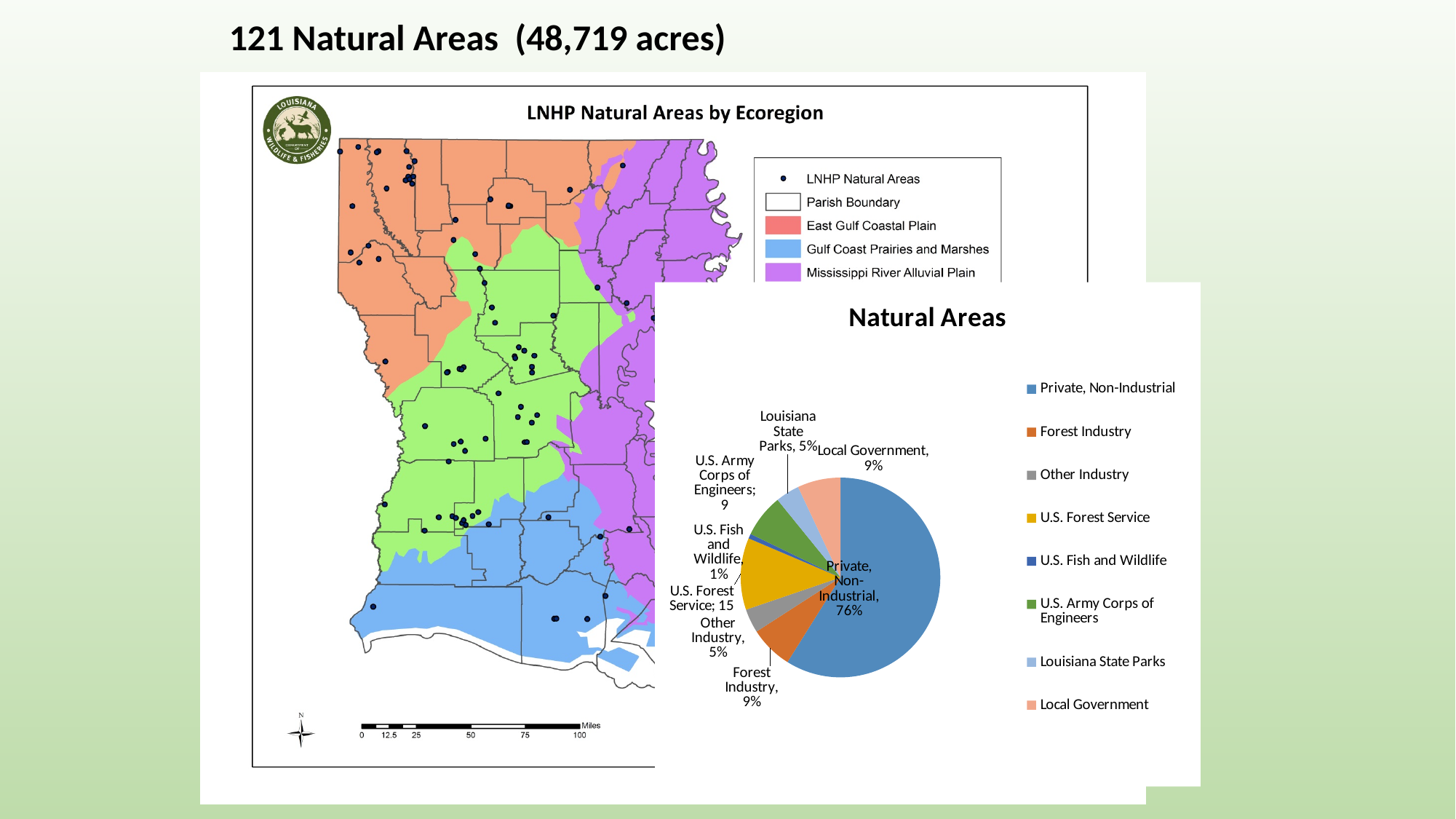
In the Natural Areas pie chart, what value is labelled for Other Industry? 5% In the Natural Areas pie chart, which category has the smallest slice? U.S. Fish and Wildlife In the Natural Areas pie chart, what share is labelled for Private, Non-Industrial? 76% In the Natural Areas pie chart, what value is labelled for Local Government? 9% How many entries does the legend of the Natural Areas chart list? 8 In the Natural Areas pie chart, what value is labelled for Forest Industry? 9% In the Natural Areas pie chart, which category has the largest slice? Private, Non-Industrial What kind of chart is the Natural Areas chart? Pie chart In the Natural Areas pie chart, how many percentage points larger is Private, Non-Industrial than Local Government? 67 percentage points In the Natural Areas pie chart, which is larger: Forest Industry or Other Industry? Forest Industry In the Natural Areas pie chart, what value is labelled for U.S. Fish and Wildlife? 1% In the Natural Areas pie chart, what value is labelled for Louisiana State Parks? 5%